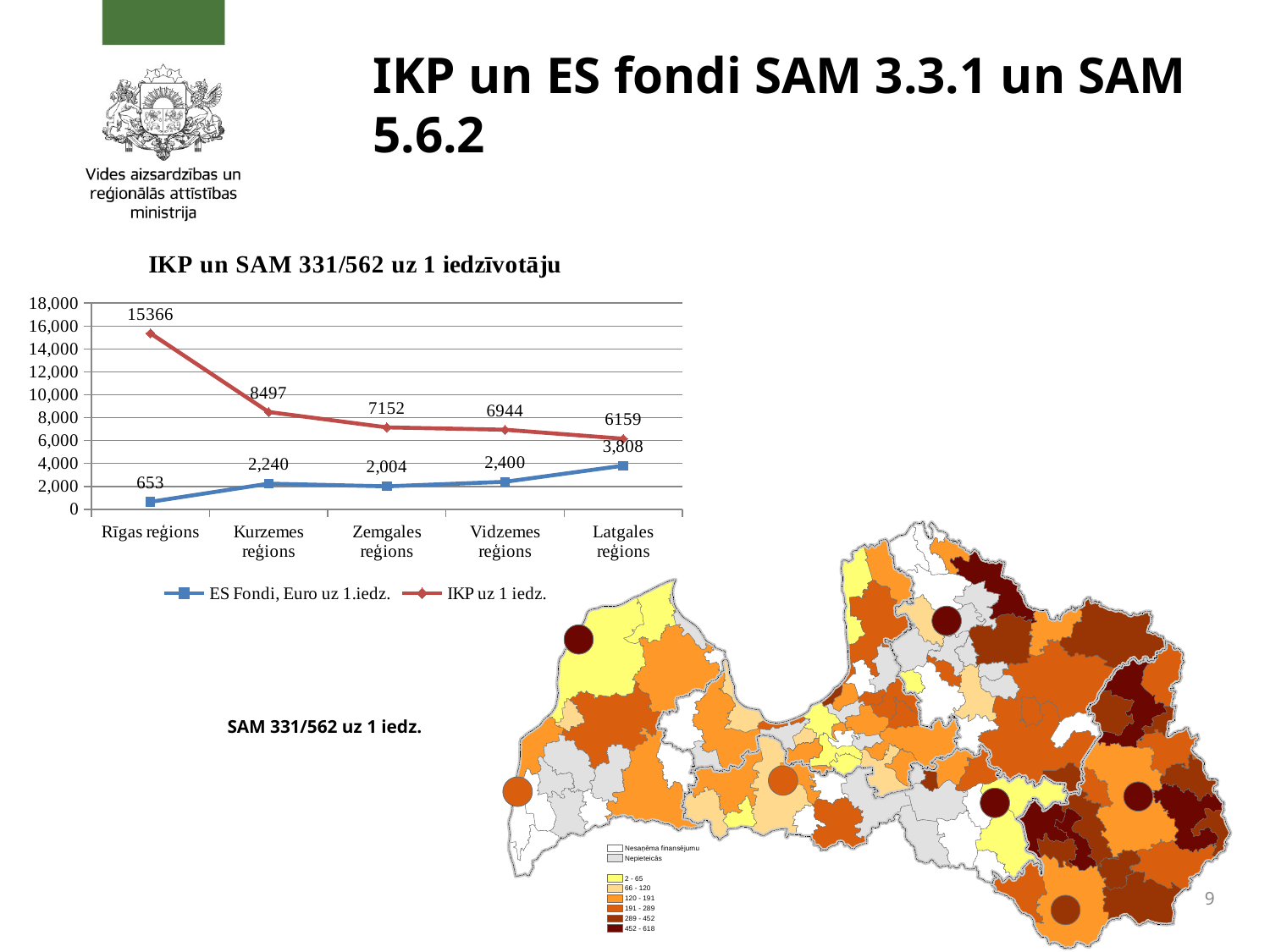
How many regions are shown on the x axis of the line chart? 5 In the line chart, what is the ES Fondi, Euro uz 1.iedz. value for Zemgales reģions? 2,004 In the line chart, what is the ES Fondi, Euro uz 1.iedz. value for Latgales reģions? 3,808 In the line chart, does the IKP uz 1 iedz. series rise or fall from Rīgas reģions to Latgales reģions? fall In the line chart, what is the difference between the IKP uz 1 iedz. values for Rīgas reģions and Kurzemes reģions? 6869 In the line chart, which region has the highest IKP uz 1 iedz. value? Rīgas reģions In the line chart, what is the IKP uz 1 iedz. value for Rīgas reģions? 15366 What kind of chart is the chart titled 'IKP un SAM 331/562 uz 1 iedzīvotāju'? line chart How many series does the legend of the line chart list? 2 In the line chart, which region has the lowest ES Fondi, Euro uz 1.iedz. value? Rīgas reģions What is the title of the line chart on the slide? IKP un SAM 331/562 uz 1 iedzīvotāju In the line chart, which region has the larger ES Fondi, Euro uz 1.iedz. value: Kurzemes reģions or Vidzemes reģions? Vidzemes reģions